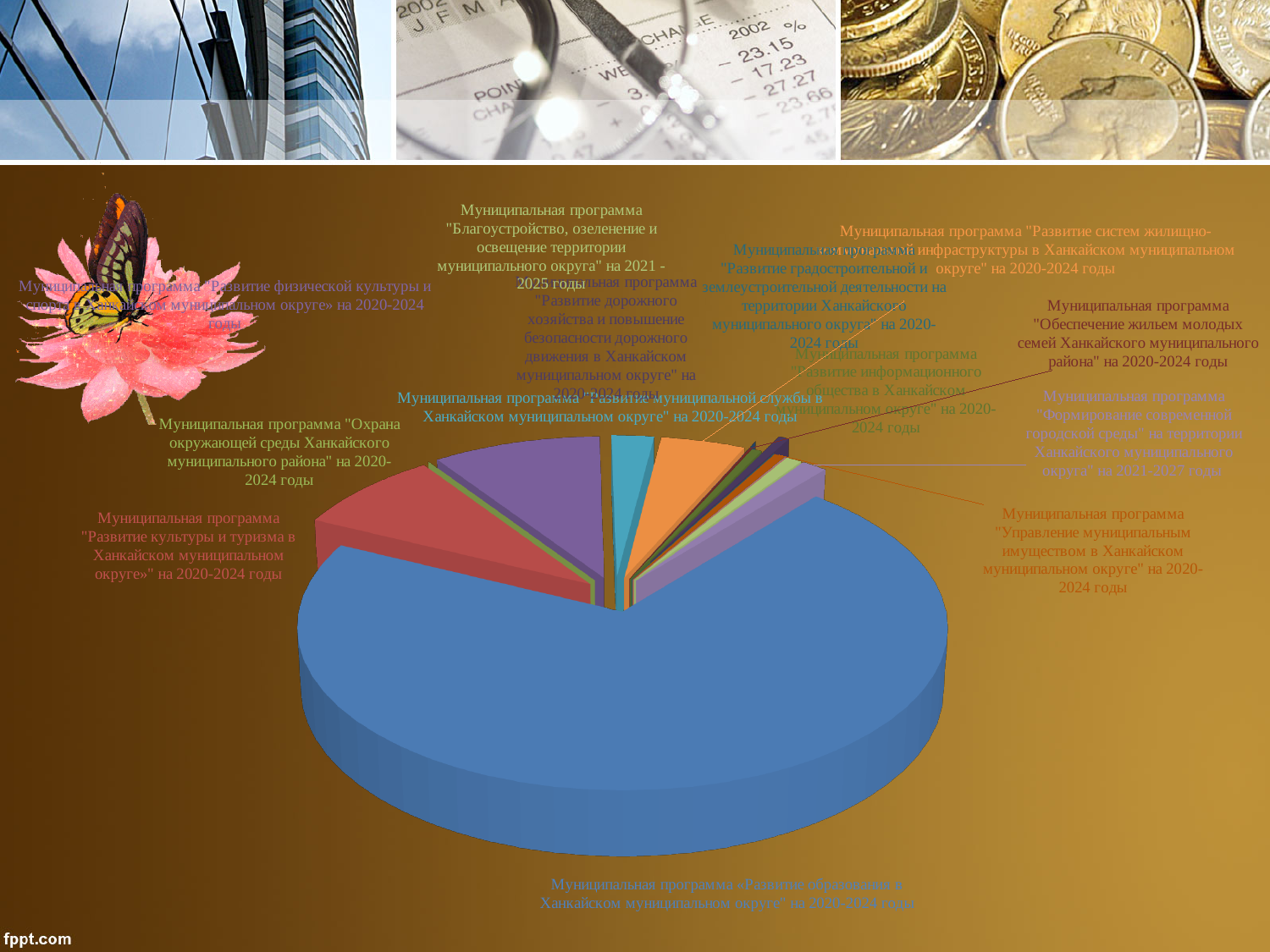
What kind of chart is shown on the slide? Pie chart Are numeric data values printed on the pie chart slices? No Which municipal program has the largest slice of the pie chart? Муниципальная программа «Развитие образования в Ханкайском муниципальном округе» на 2020-2024 годы What colour is the largest slice of the pie chart? Blue Which slice is larger: the one for «Развитие образования в Ханкайском муниципальном округе» or the one for «Развитие культуры и туризма в Ханкайском муниципальном округе»? «Развитие образования в Ханкайском муниципальном округе» Which slice is larger: the one for «Развитие образования в Ханкайском муниципальном округе» or the one for «Обеспечение жильем молодых семей Ханкайского муниципального района»? «Развитие образования в Ханкайском муниципальном округе»